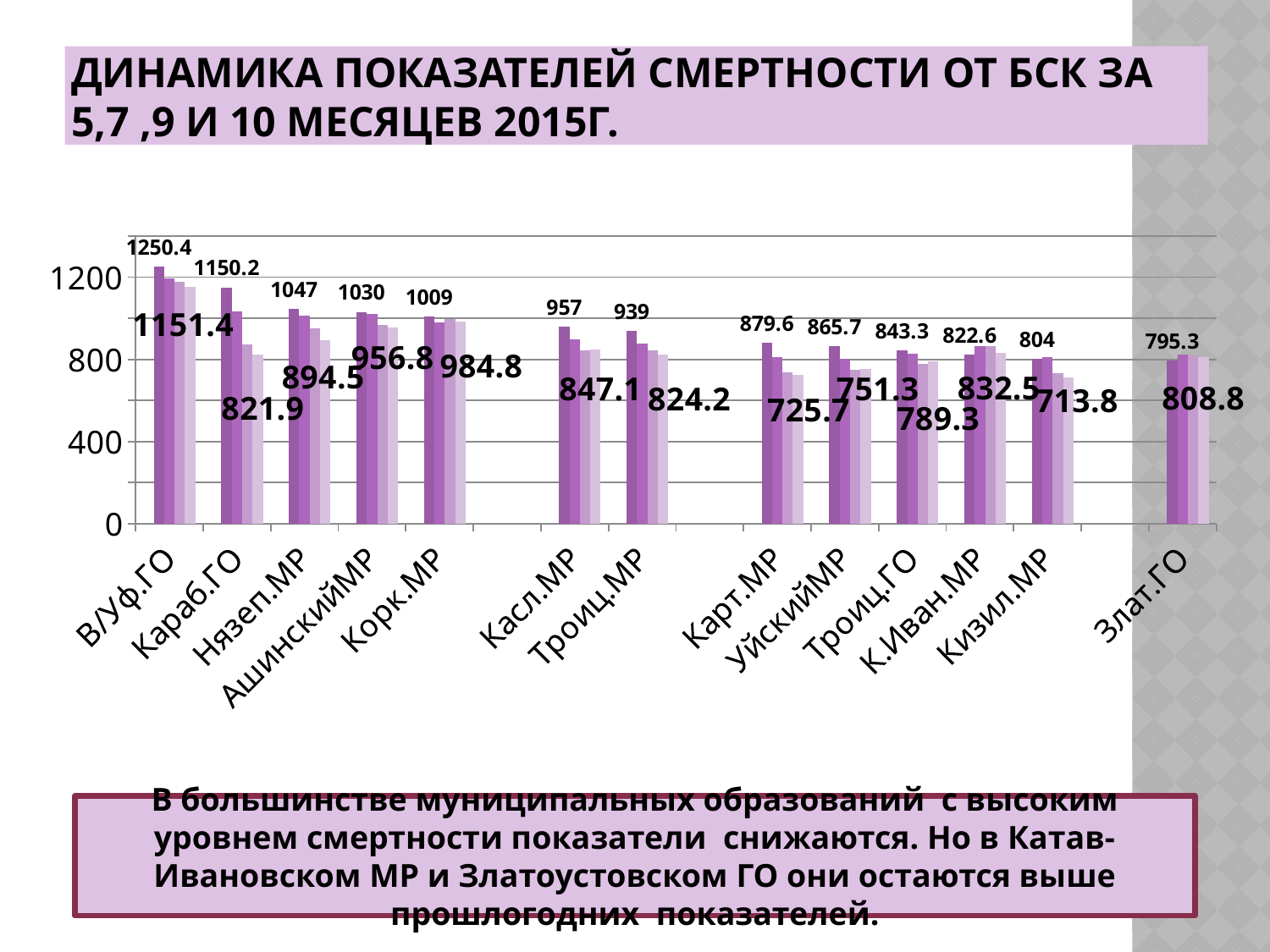
Which municipality has the lowest value among the small data labels above the first bars? Злат.ГО What is the large data label shown for Кизил.МР? 713.8 What is the value of the small data label above the first bar for Караб.ГО? 1150.2 How many municipalities (categories) are shown on the x axis of the chart? 13 What is the value of the small data label above the first bar for Касл.МР? 957 What is the large data label shown for Корк.МР? 984.8 What is the difference between the first-bar values of В/Уф.ГО (1250.4) and Караб.ГО (1150.2)? 100.2 Which municipality has the highest value among the small data labels above the first bars? В/Уф.ГО What type of chart is shown on the slide? bar chart Do the values of the first bars rise or fall from left to right across the municipalities? fall What is the value of the small data label above the first bar for В/Уф.ГО? 1250.4 What is the value of the small data label above the first bar for Злат.ГО? 795.3